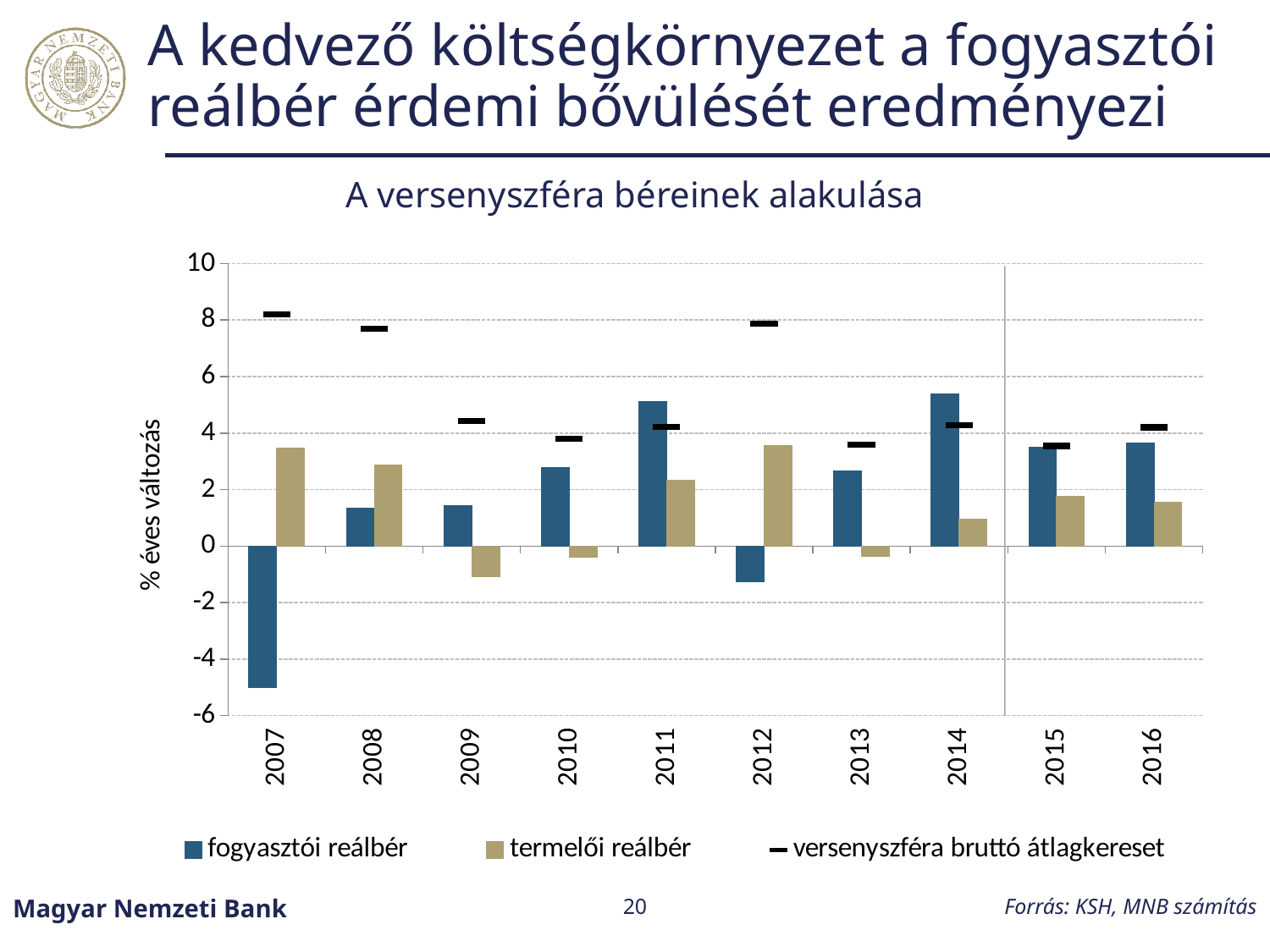
In 2012, which is larger: fogyasztói reálbér or termelői reálbér? termelői reálbér In which year is the fogyasztói reálbér bar the highest? 2014 What kind of chart is shown on the slide? bar chart Is the fogyasztói reálbér value for 2011 greater or less than 4? greater In which year is the termelői reálbér bar the lowest? 2009 How many years are shown on the x axis of the chart? 10 In which year is the fogyasztói reálbér bar the lowest? 2007 Does the versenyszféra bruttó átlagkereset rise or fall from 2007 to 2010? fall What is the label on the chart's vertical axis? % éves változás Is the fogyasztói reálbér value for 2007 greater or less than -4? less How many series does the chart's legend list? 3 Is the versenyszféra bruttó átlagkereset value for 2007 greater or less than 8? greater